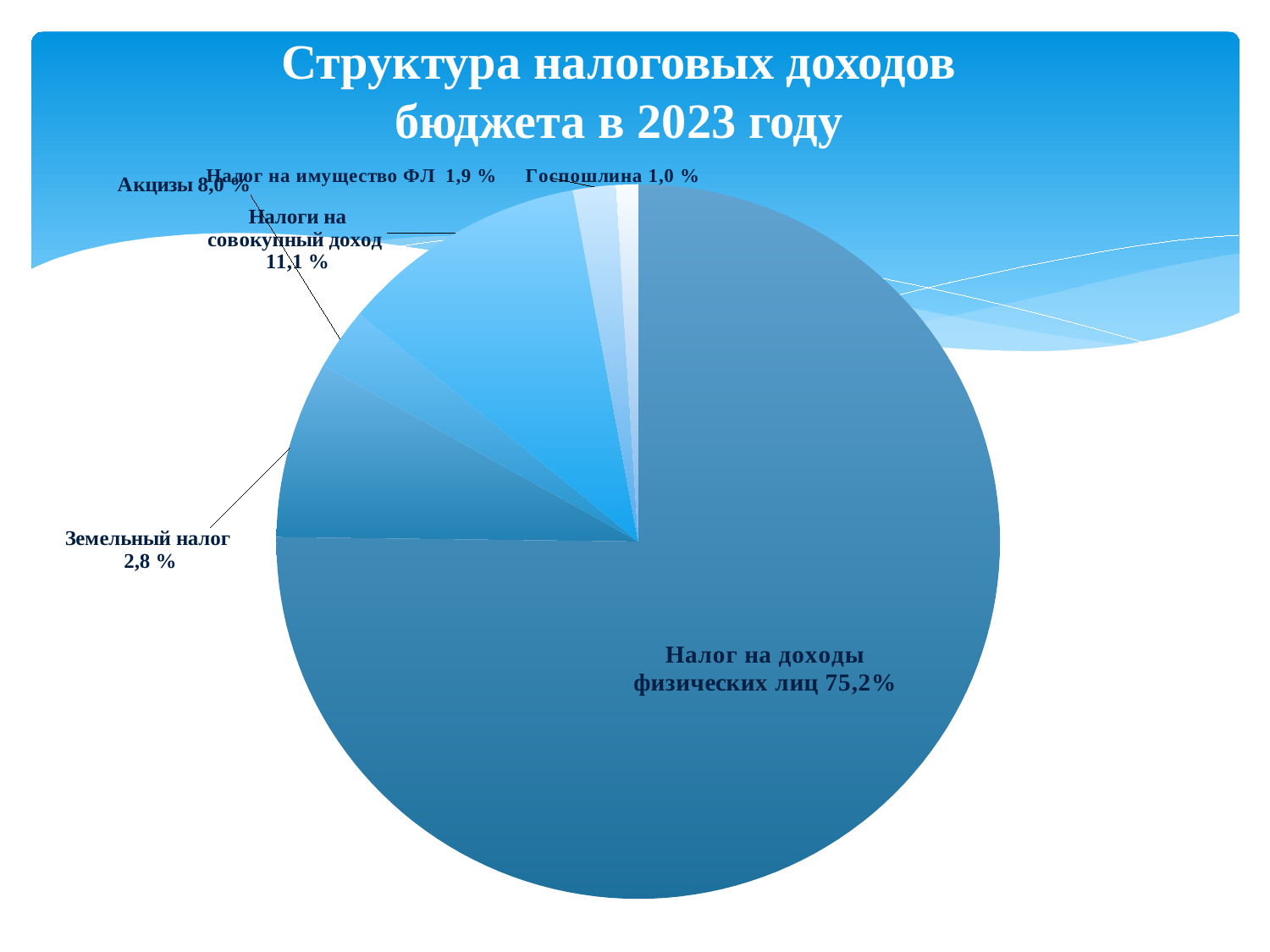
Which category has the largest share of the pie? Налог на доходы физических лиц Which category has the smallest share of the pie? Госпошлина Which is larger, Акцизы or Налог на имущество ФЛ? Акцизы What kind of chart is shown on the slide? Pie chart What is the title of the chart? Структура налоговых доходов бюджета в 2023 году What is the value shown for Налоги на совокупный доход? 11,1 % What is the value shown for Акцизы? 8,0 % What is the value shown for Земельный налог? 2,8 % What is the difference between the shares of Налоги на совокупный доход and Акцизы? 3,1 % What is the value shown for Госпошлина? 1,0 % What share of the pie is Налог на доходы физических лиц? 75,2% How many slices does the pie chart have? 6